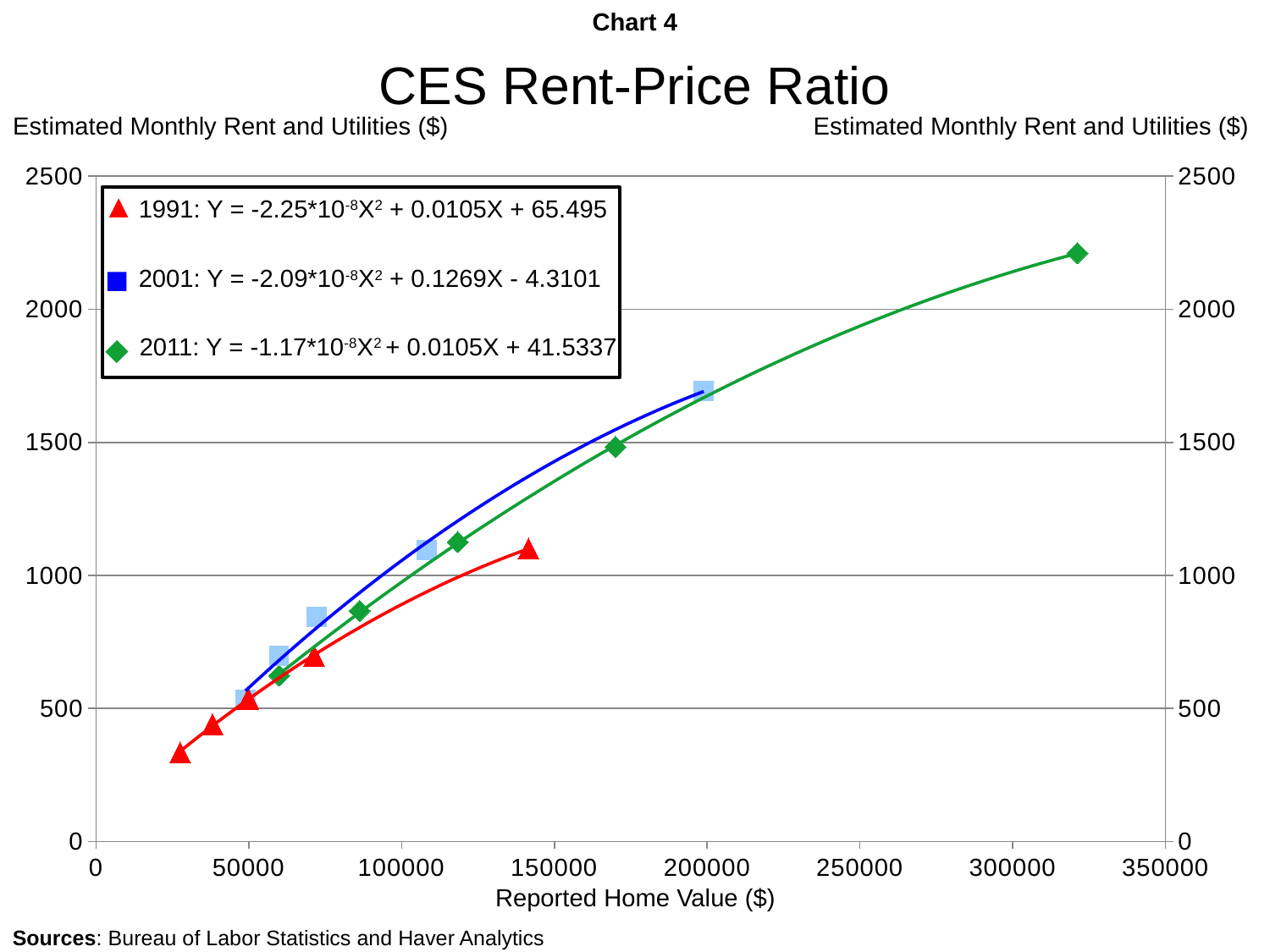
Which series reaches a higher estimated monthly rent at its highest plotted point, 1991 or 2001? 2001 Is the estimated monthly rent for the highest 2011 point greater or less than 2000? greater Which series reaches the highest estimated monthly rent on the chart? 2011 What is the label of the x axis? Reported Home Value ($) How many series does the legend list? 3 How many data points are plotted for the 2011 series? 5 Is the estimated monthly rent for the lowest 1991 point greater or less than 500? less Which series contains the lowest plotted estimated monthly rent value? 1991 What kind of chart is shown on the slide? scatter chart Is the estimated monthly rent for the highest 1991 point greater or less than 1000? greater Do the estimated monthly rent values rise or fall as reported home value increases? rise What is the title of the chart? CES Rent-Price Ratio